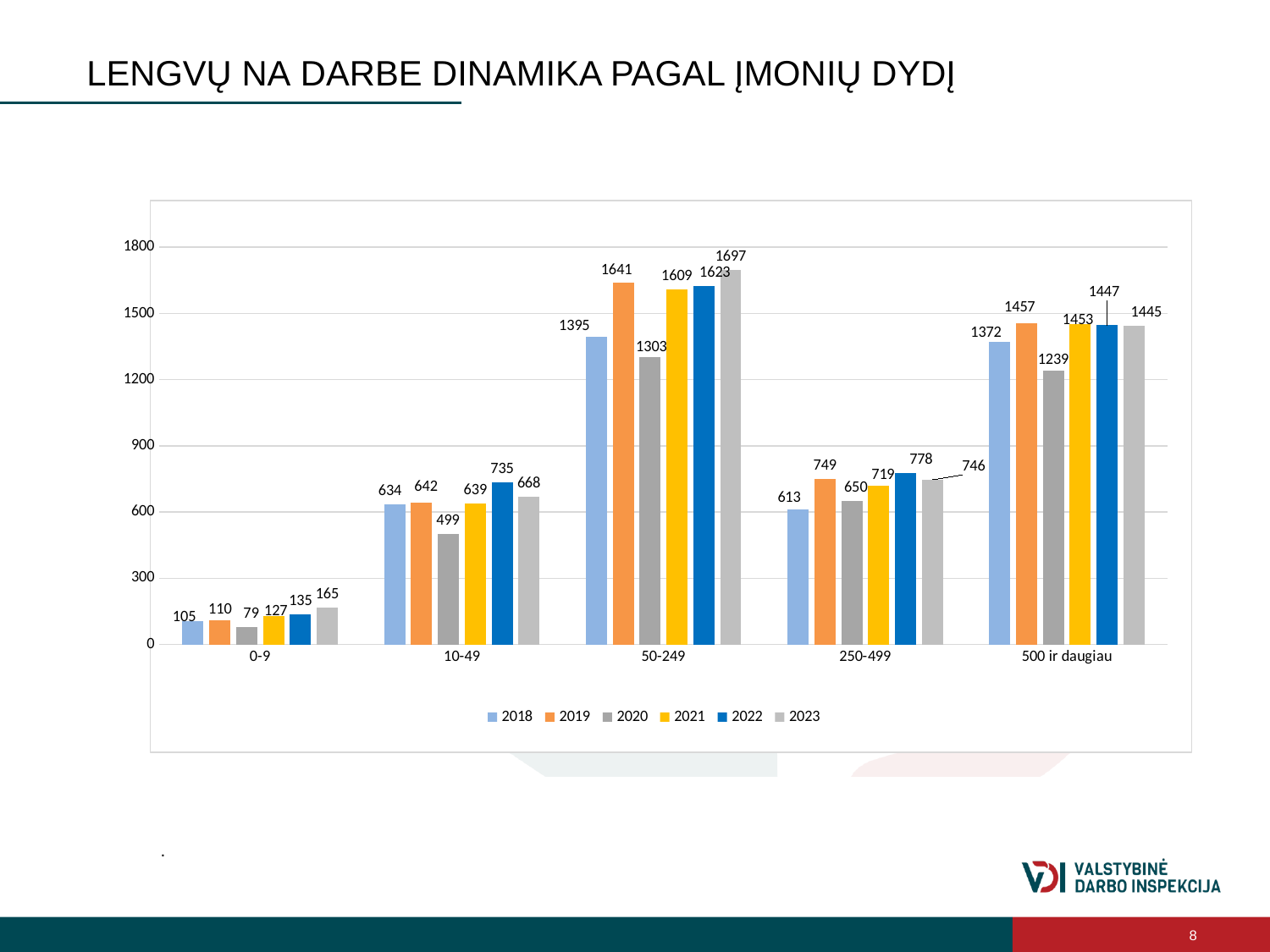
Is the value for 2021 in the 250-499 category greater or less than 900? less Which year has the lowest value in the 250-499 category? 2018 How many company-size categories are shown on the x axis? 5 How many series does the legend list? 6 What is the value for 2018 in the 500 ir daugiau category? 1372 What is the title of the slide? LENGVŲ NA DARBE DINAMIKA PAGAL ĮMONIŲ DYDĮ Which is larger in the 500 ir daugiau category: the 2019 value or the 2020 value? 2019 What is the difference between the 2019 and 2020 values in the 50-249 category? 338 What kind of chart is shown on the slide? bar chart Which year has the highest value in the 10-49 category? 2022 What is the value for 2020 in the 0-9 category? 79 What is the value for 2023 in the 50-249 category? 1697